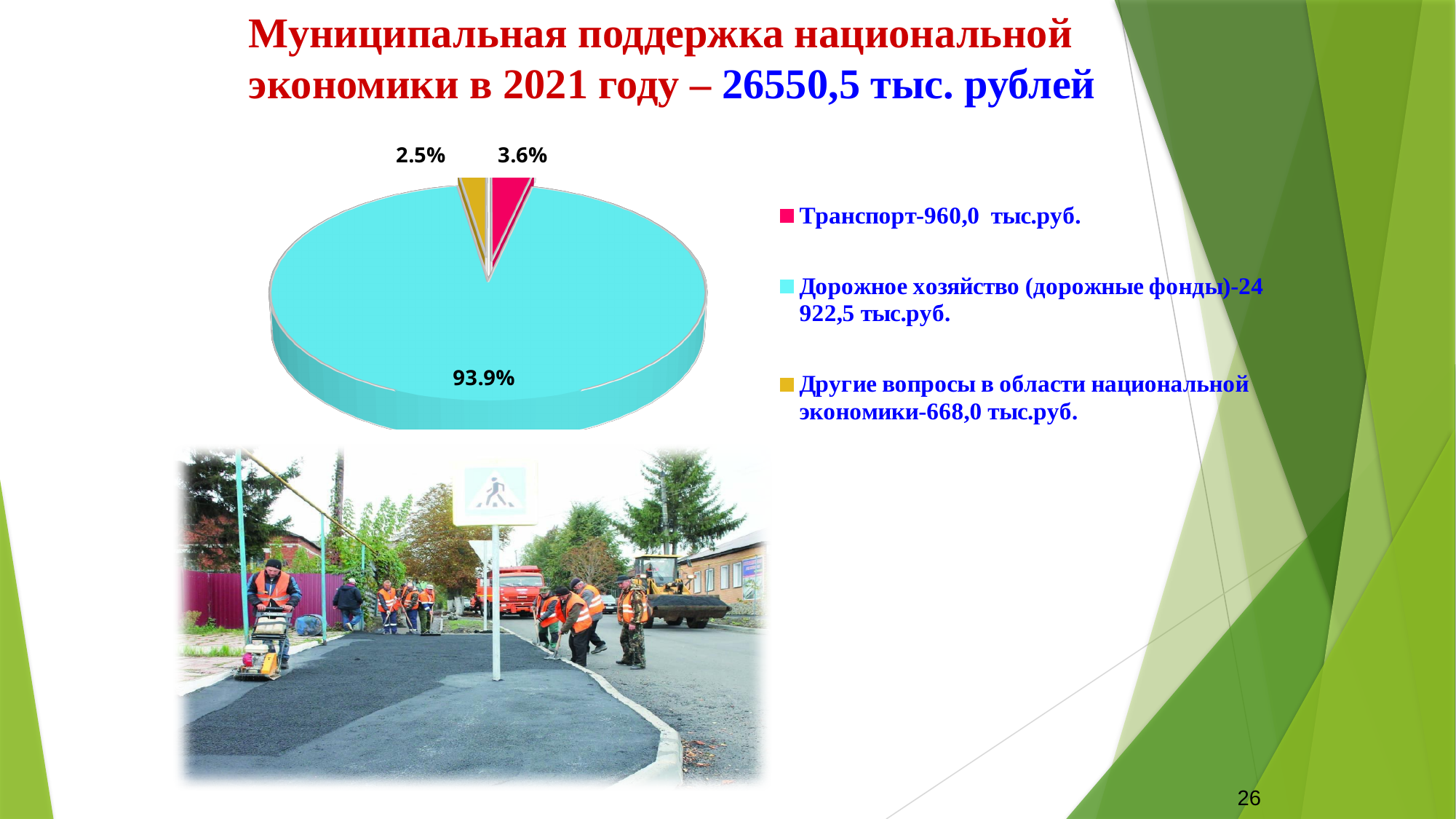
What share of the pie does Транспорт take? 3.6% What share of the pie does Дорожное хозяйство (дорожные фонды) take? 93.9% Which category has the smallest slice of the pie? Другие вопросы в области национальной экономики What amount is given in the legend for Другие вопросы в области национальной экономики? 668,0 тыс.руб. How many slices does the pie chart have? 3 Which category has the largest slice of the pie? Дорожное хозяйство (дорожные фонды) What share of the pie does Другие вопросы в области национальной экономики take? 2.5% What amount is given in the legend for Транспорт? 960,0 тыс.руб. How many entries does the legend of the pie chart list? 3 Which colour represents Транспорт in the pie chart? red What amount is given in the legend for Дорожное хозяйство (дорожные фонды)? 24 922,5 тыс.руб. What kind of chart is shown on the slide? pie chart